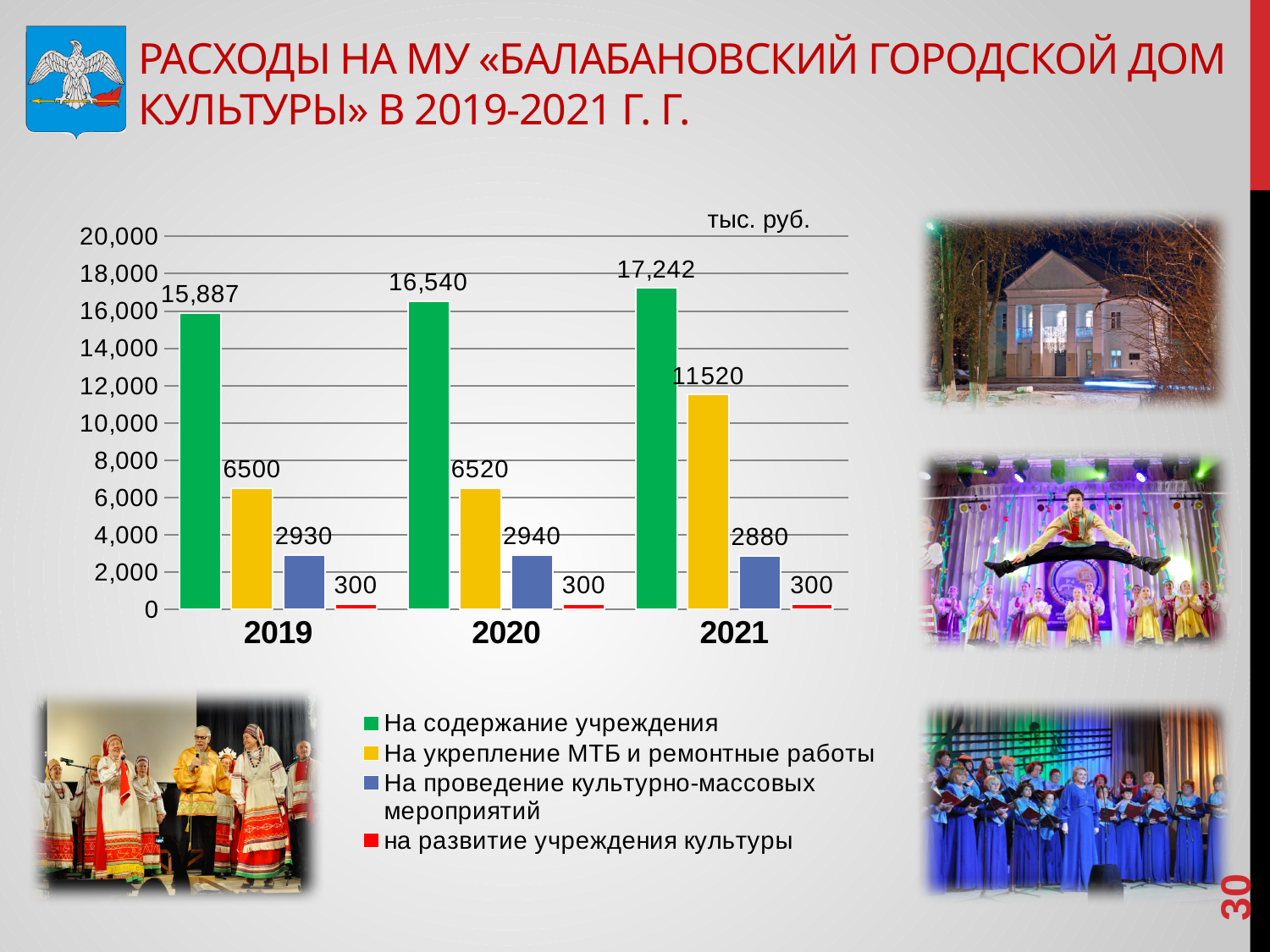
How many series does the legend list? 4 In which year is the value for «На содержание учреждения» the highest? 2021 Which is larger: «На содержание учреждения» in 2019 or in 2020? 2020 What is the value for «на развитие учреждения культуры» in 2021? 300 What is the value for «На укрепление МТБ и ремонтные работы» in 2020? 6520 In which year is the value for «На проведение культурно-массовых мероприятий» the lowest? 2021 What is the value for «На проведение культурно-массовых мероприятий» in 2019? 2930 What is the value for «На содержание учреждения» in 2021? 17,242 How many years (categories) are shown on the x axis? 3 Does the value for «На содержание учреждения» rise or fall from 2019 to 2021? rise What is the difference between the «На укрепление МТБ и ремонтные работы» values for 2021 and 2020? 5000 What kind of chart is shown on the slide? bar chart